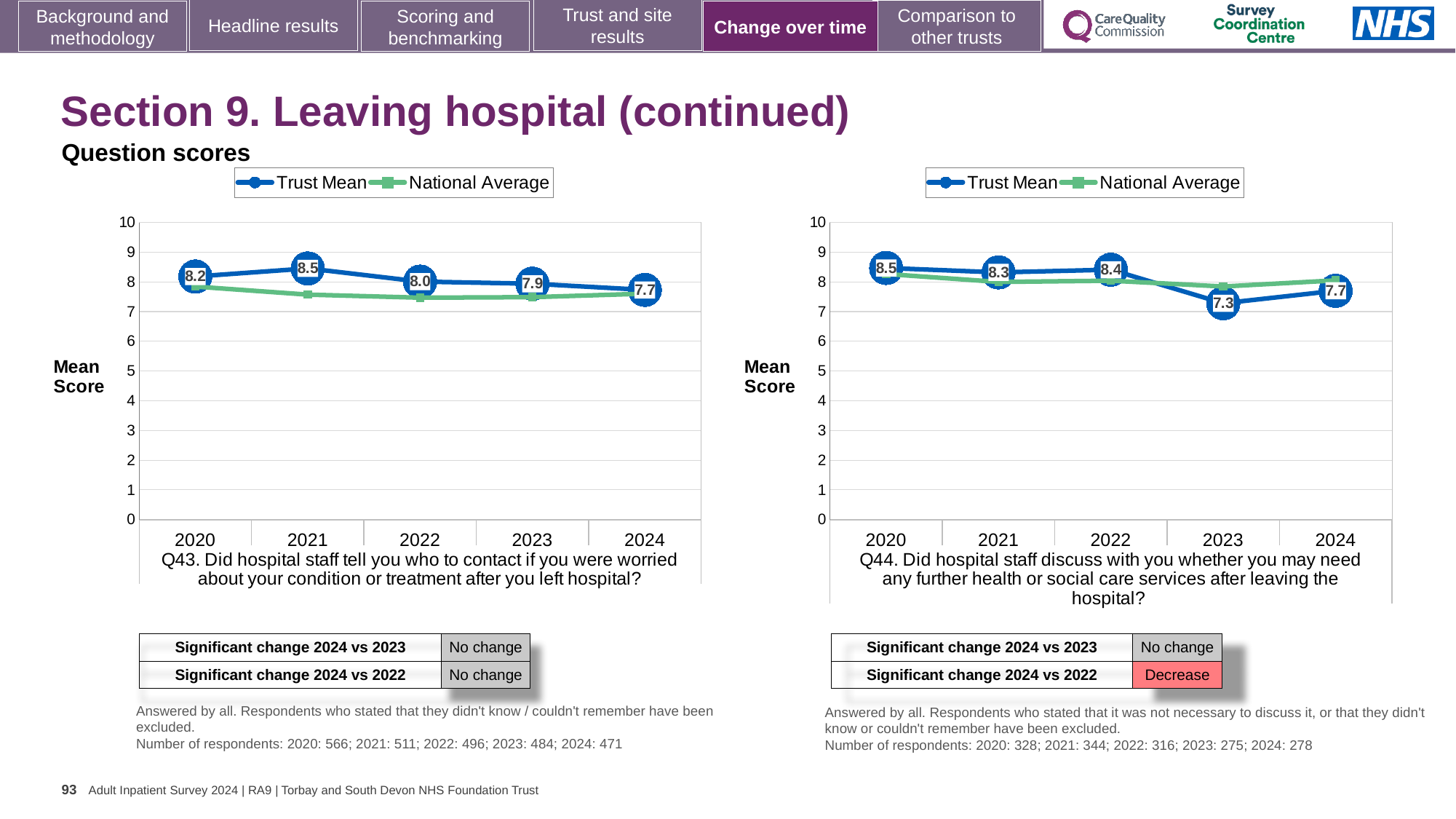
In the Q44 chart on the right, which year has the lowest Trust Mean score? 2023 In the Q44 chart on the right, what is the Trust Mean score for 2023? 7.3 In the Q43 chart on the left, which year has the highest Trust Mean score? 2021 How many series does the legend of the Q43 chart on the left list? 2 In the Q44 chart on the right, which year has the highest Trust Mean score? 2020 What kind of chart is the Q44 chart on the right? line chart In the Q44 chart on the right, is the National Average for 2023 greater or less than 7? greater In the Q43 chart on the left, what is the Trust Mean score for 2021? 8.5 In the Q43 chart on the left, what is the difference between the Trust Mean scores for 2021 and 2024? 0.8 In the Q43 chart on the left, what is the Trust Mean score for 2024? 7.7 In the Q43 chart on the left, which year has the lowest Trust Mean score? 2024 In the Q44 chart on the right, is the Trust Mean score for 2020 larger or smaller than the score for 2023? larger